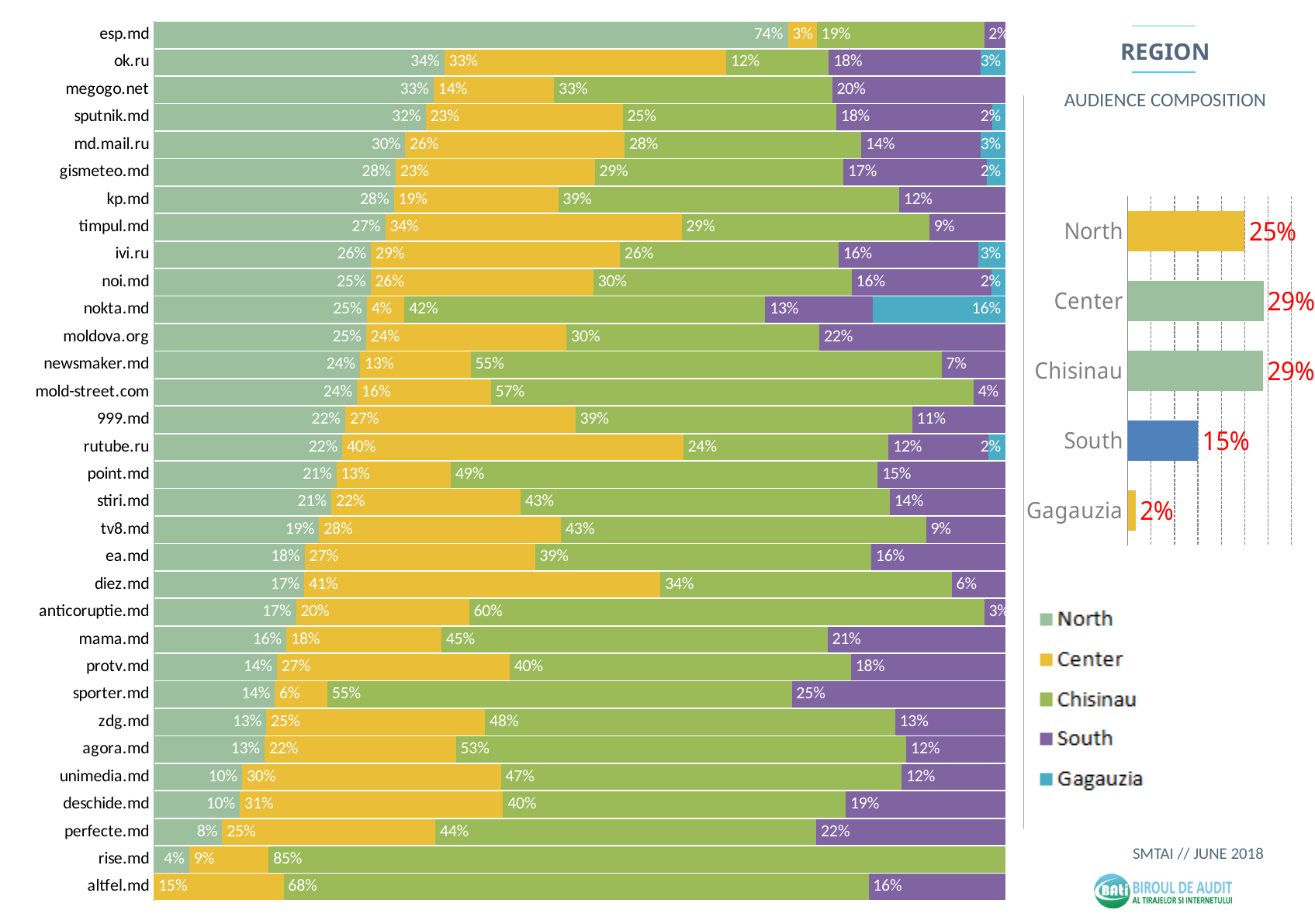
In the REGION chart on the right, which region has the lowest value? Gagauzia In the large stacked bar chart on the left, what is the difference between anticoruptie.md's Chisinau share and its Center share? 40% In the large stacked bar chart on the left, which website has the highest Chisinau share? rise.md In the REGION chart on the right, what is the difference between North and South? 10% In the large stacked bar chart on the left, what share of nokta.md's audience comes from Gagauzia? 16% What kind of chart is the REGION chart on the right? Bar chart In the large stacked bar chart on the left, what share of rise.md's audience comes from Chisinau? 85% How many series does the legend of the large stacked bar chart on the left list? 5 How many websites are shown in the large stacked bar chart on the left? 32 In the large stacked bar chart on the left, what share of esp.md's audience comes from the North region? 74% In the REGION chart on the right, what is the value for South? 15% In the large stacked bar chart on the left, which website has the highest North share? esp.md